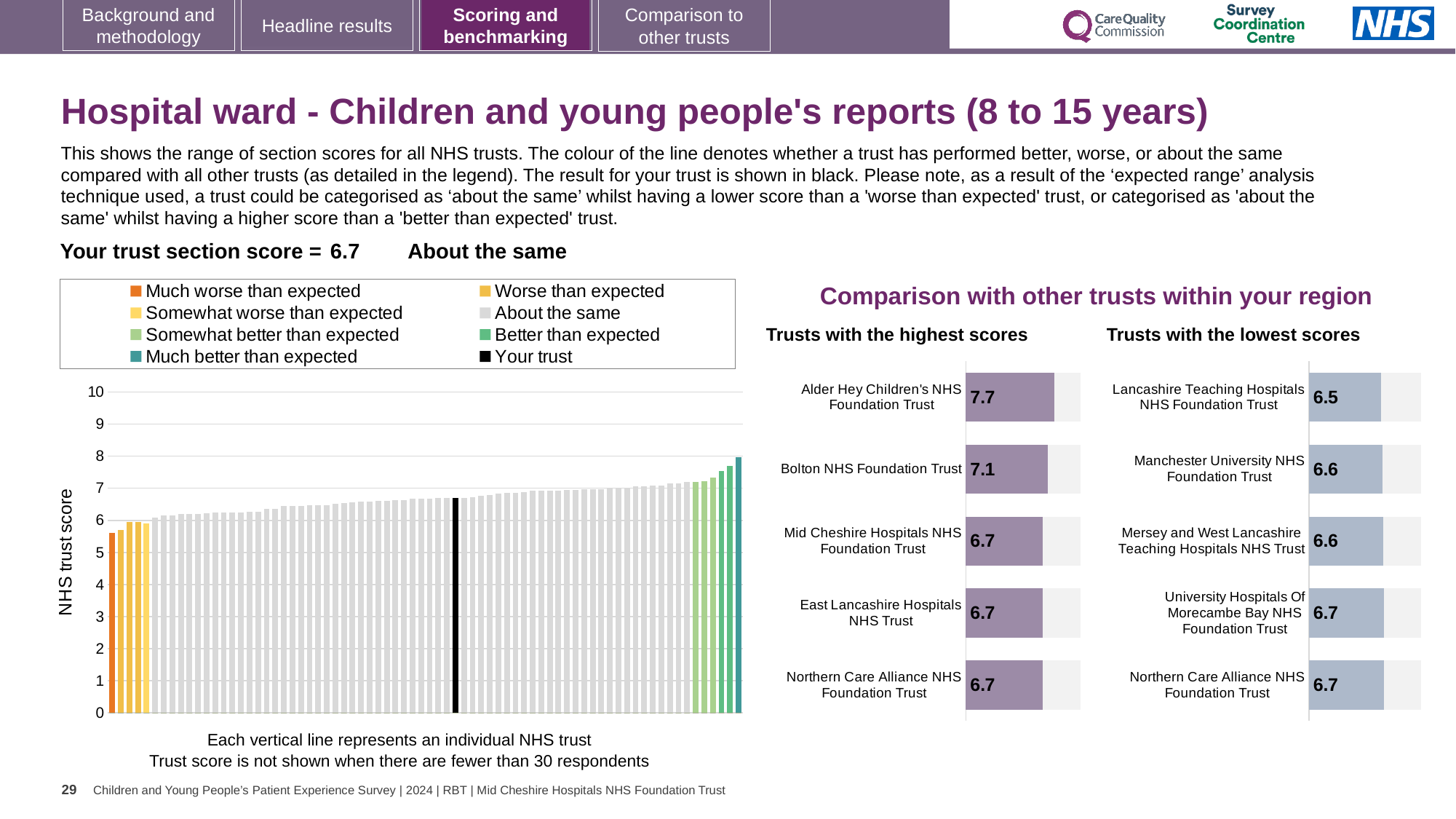
In the 'Trusts with the highest scores' chart, what is the difference between the scores of Alder Hey Children's NHS Foundation Trust and Bolton NHS Foundation Trust? 0.6 How many trusts are shown in the 'Trusts with the lowest scores' chart? 5 In the 'Trusts with the lowest scores' chart, what is the score for Lancashire Teaching Hospitals NHS Foundation Trust? 6.5 In the 'Trusts with the lowest scores' chart, what is the score for Manchester University NHS Foundation Trust? 6.6 In the 'Trusts with the lowest scores' chart, which trust has the lowest score? Lancashire Teaching Hospitals NHS Foundation Trust In the 'Trusts with the highest scores' chart, what is the score for Alder Hey Children's NHS Foundation Trust? 7.7 In the 'Trusts with the highest scores' chart, what is the score for Bolton NHS Foundation Trust? 7.1 In the 'Trusts with the highest scores' chart, which trust has the highest score? Alder Hey Children's NHS Foundation Trust In the large chart on the left showing all NHS trusts, is the value for the black 'Your trust' bar greater or less than 7? less How many entries does the legend above the large chart on the left list? 8 In the large chart on the left showing all NHS trusts, do the bar values rise or fall from left to right? rise Which is larger: the score for Alder Hey Children's NHS Foundation Trust in the highest scores chart or the score for Lancashire Teaching Hospitals NHS Foundation Trust in the lowest scores chart? Alder Hey Children's NHS Foundation Trust